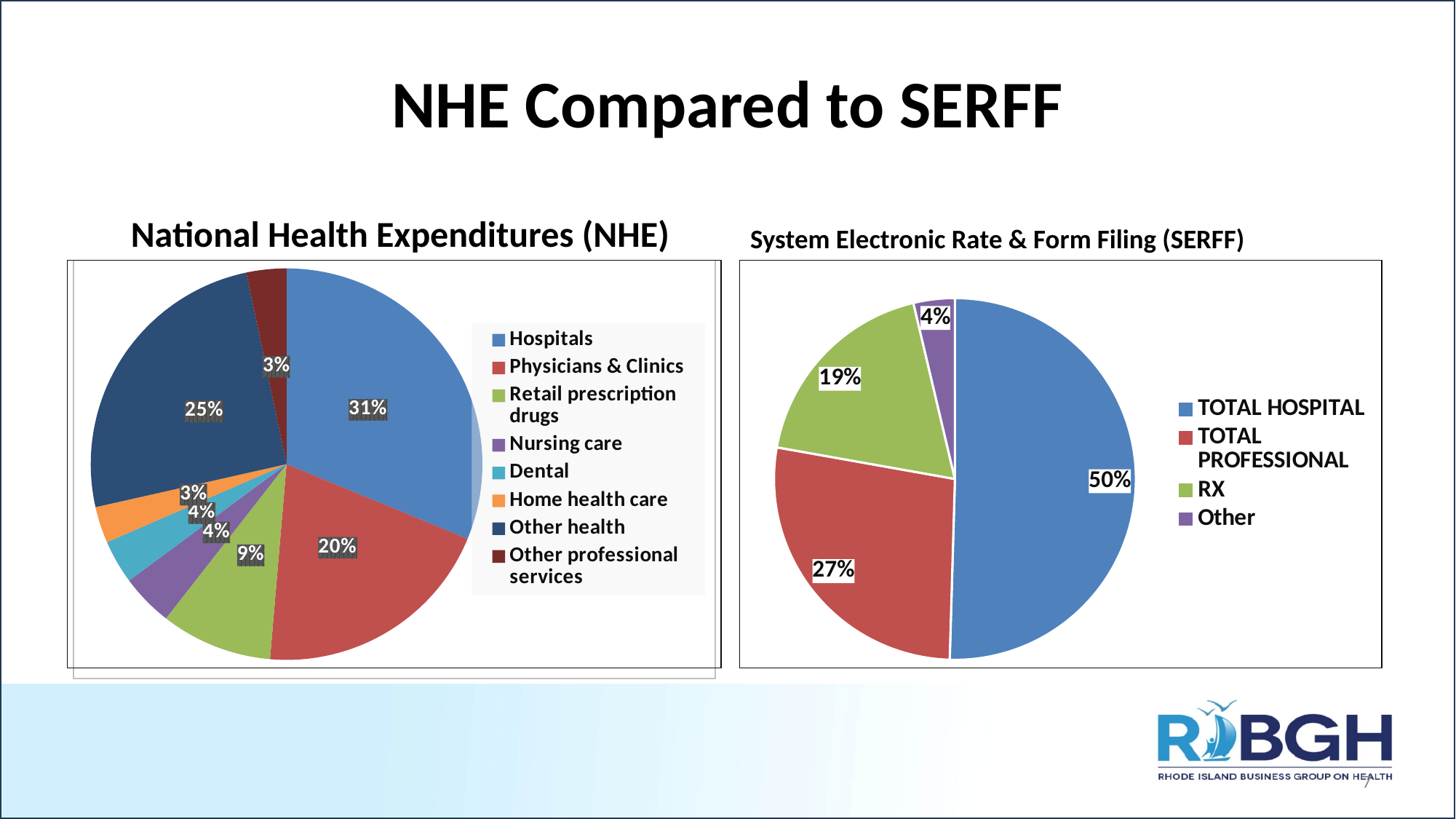
In the National Health Expenditures (NHE) chart, how many categories does the legend list? 8 In the National Health Expenditures (NHE) chart, what share is Retail prescription drugs? 9% In the National Health Expenditures (NHE) chart, what share is Other health? 25% In the National Health Expenditures (NHE) chart, what share is Physicians & Clinics? 20% In the System Electronic Rate & Form Filing (SERFF) chart, which category has the smallest share? Other In the National Health Expenditures (NHE) chart, what is the difference between the Hospitals share and the Physicians & Clinics share? 11% In the System Electronic Rate & Form Filing (SERFF) chart, what share is TOTAL HOSPITAL? 50% What type of chart is used for the System Electronic Rate & Form Filing (SERFF) data? Pie chart In the System Electronic Rate & Form Filing (SERFF) chart, what share is RX? 19% In the System Electronic Rate & Form Filing (SERFF) chart, what is the difference between TOTAL PROFESSIONAL and RX? 8% In the National Health Expenditures (NHE) chart, what share is Hospitals? 31% In the National Health Expenditures (NHE) chart, which category has the largest share? Hospitals